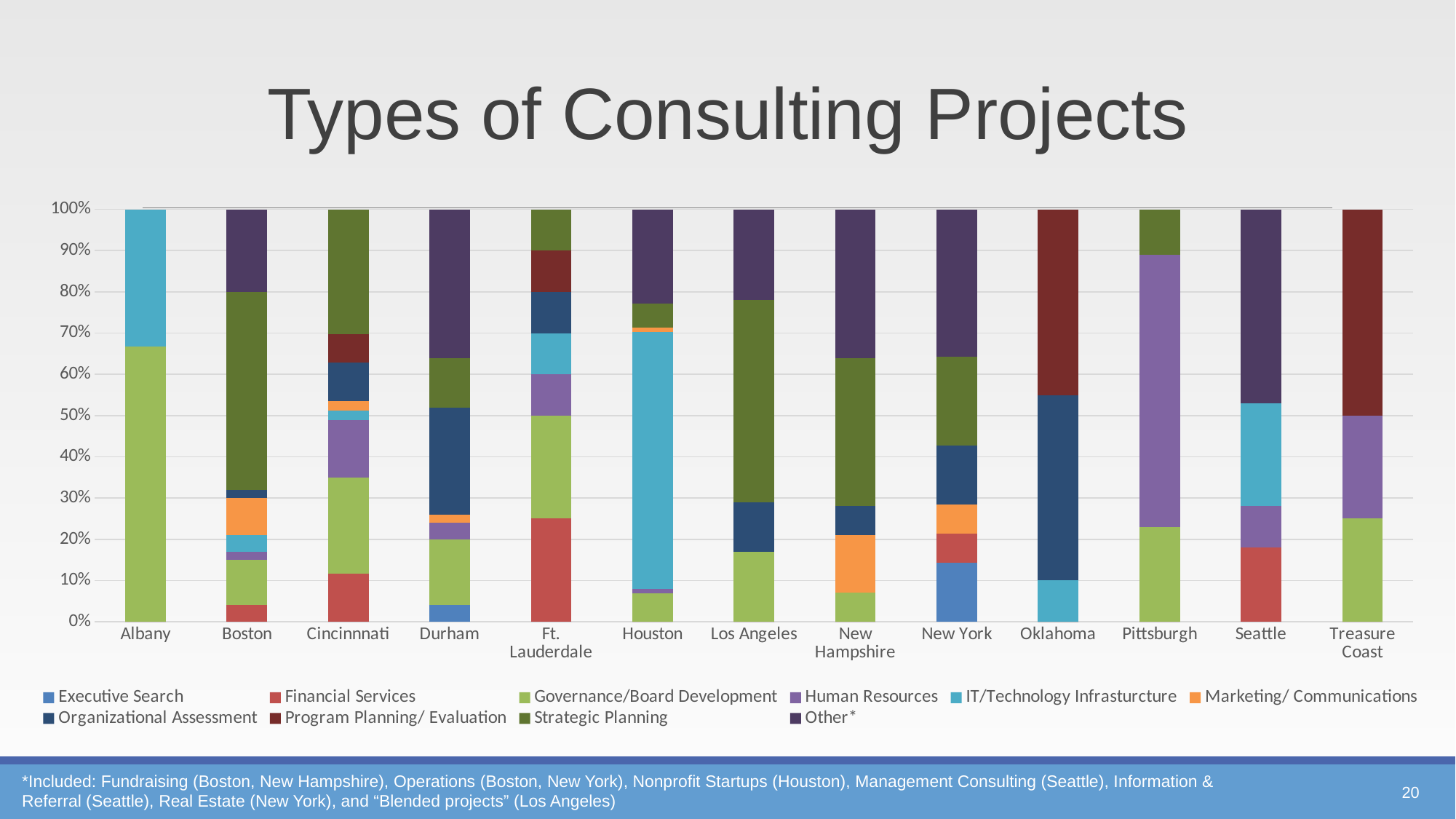
Is the IT/Technology Infrastructure share for Houston greater or less than 50%? greater Which city has the larger IT/Technology Infrastructure share, Houston or Seattle? Houston Is the Human Resources share for Pittsburgh greater or less than 50%? greater Which city has the largest Human Resources share? Pittsburgh Is the Other* share for Seattle greater or less than 40%? greater How many series does the chart legend list? 10 What is the title of the chart? Types of Consulting Projects What type of chart is shown on the slide? Stacked bar chart Which city has the largest Governance/Board Development share? Albany How many cities (categories) are shown on the x axis of the chart? 13